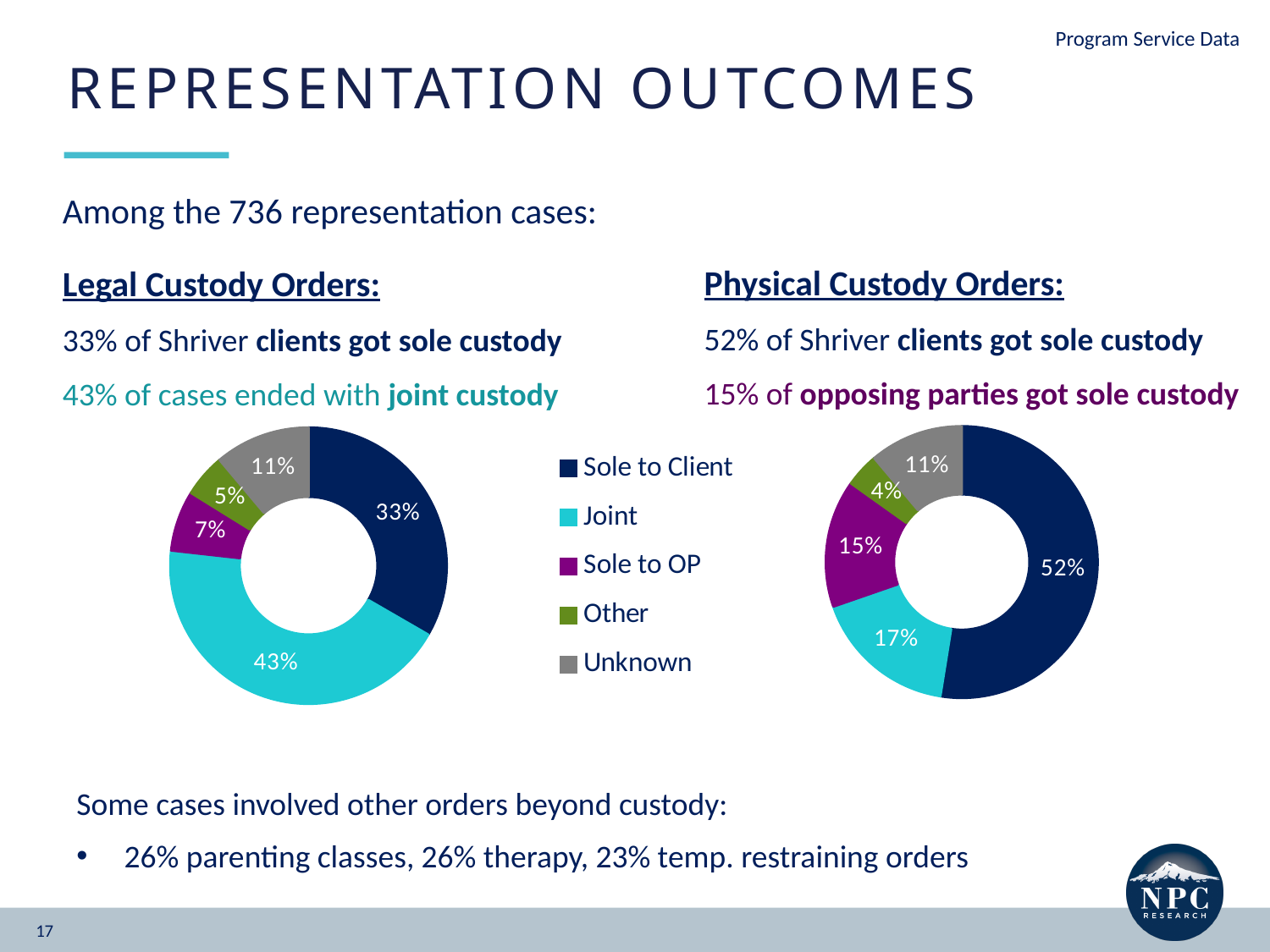
How many categories does the legend shared by the two charts list? 5 What type of chart is used for the Legal Custody Orders and Physical Custody Orders data? Pie (donut) chart In the left chart (Legal Custody Orders), what is the difference between the Joint share and the Sole to Client share? 10% In the right chart (Physical Custody Orders), what is the difference between the Sole to Client share and the Joint share? 35% In the left chart (Legal Custody Orders), which category has the largest share? Joint In the right chart (Physical Custody Orders), what share of cases is Other? 4% In the left chart (Legal Custody Orders), what share of cases ended with Joint custody? 43% Which is larger in the right chart (Physical Custody Orders): the Joint share or the Sole to OP share? Joint In the left chart (Legal Custody Orders), what share of cases is Sole to OP? 7% In the left chart (Legal Custody Orders), which category has the smallest share? Other In the right chart (Physical Custody Orders), what share of cases is Sole to Client? 52% In the right chart (Physical Custody Orders), which category has the smallest share? Other